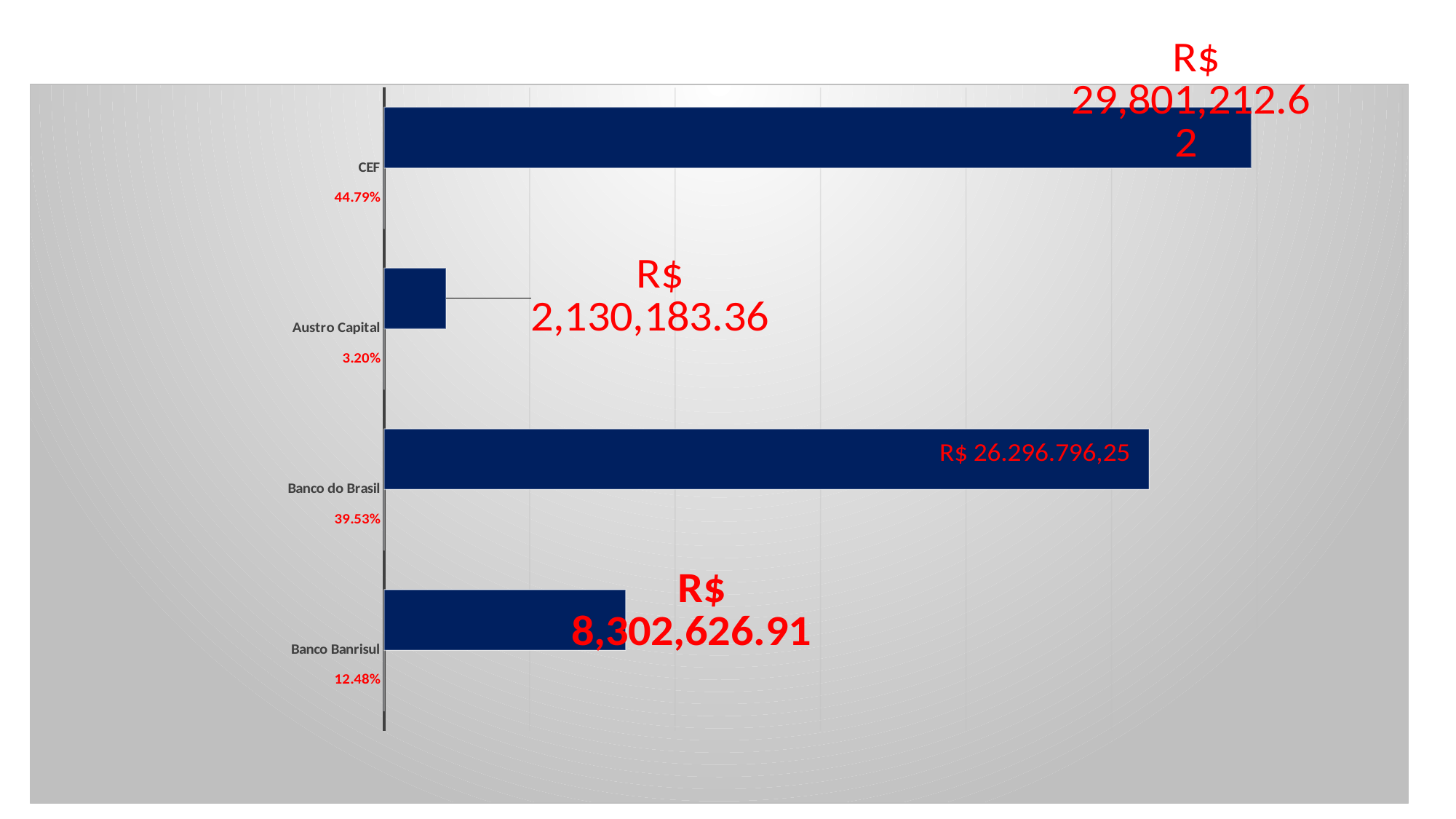
What is the value shown for Banco do Brasil? R$ 26.296.796,25 How many categories are plotted in the chart? 4 Which category has the highest value? CEF What is the difference between the percentage shown for CEF and the percentage shown for Banco do Brasil? 5.26% What is the value shown for CEF? R$ 29,801,212.62 Which category has the lowest value? Austro Capital What type of chart is shown on the slide? bar chart What percentage is shown under the Banco Banrisul label? 12.48% What percentage is shown under the CEF label? 44.79% What is the value shown for Austro Capital? R$ 2,130,183.36 What is the value shown for Banco Banrisul? R$ 8,302,626.91 Which is larger, the value for Banco Banrisul or the value for Austro Capital? Banco Banrisul